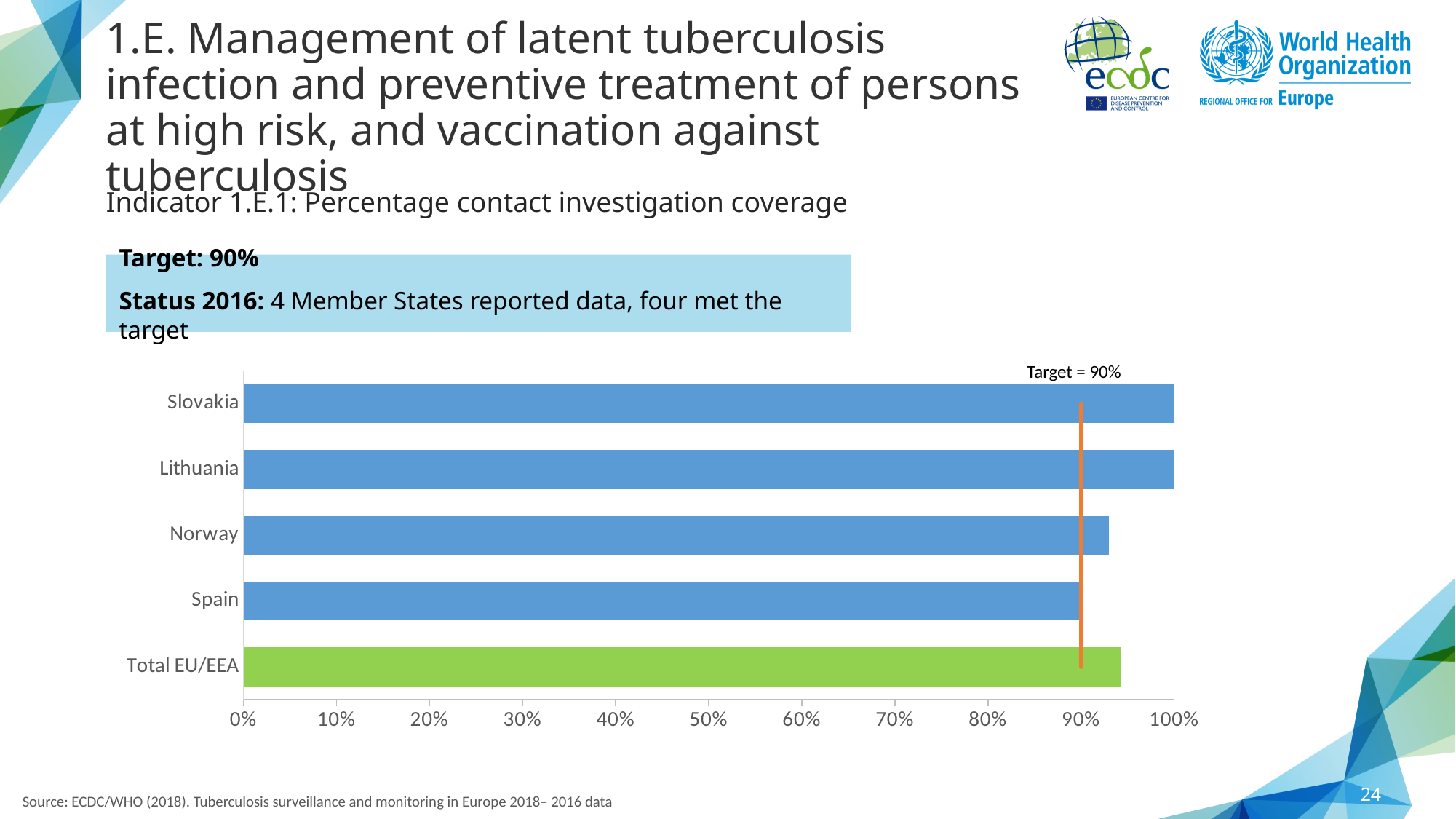
Which category's bar is coloured green rather than blue? Total EU/EEA Which has a higher value, Total EU/EEA or Spain? Total EU/EEA What is the percentage contact investigation coverage for Lithuania? 100% Which has a higher value, Norway or Spain? Norway Is the value for Total EU/EEA greater or less than 90%? greater What kind of chart is shown on the slide? bar chart Which category has the lowest value in the chart? Spain How many categories are plotted in the chart? 5 What is the percentage contact investigation coverage for Slovakia? 100% Is the value for Norway greater or less than 90%? greater Is the value for Spain greater or less than 80%? greater What target value is marked by the vertical line in the chart? 90%